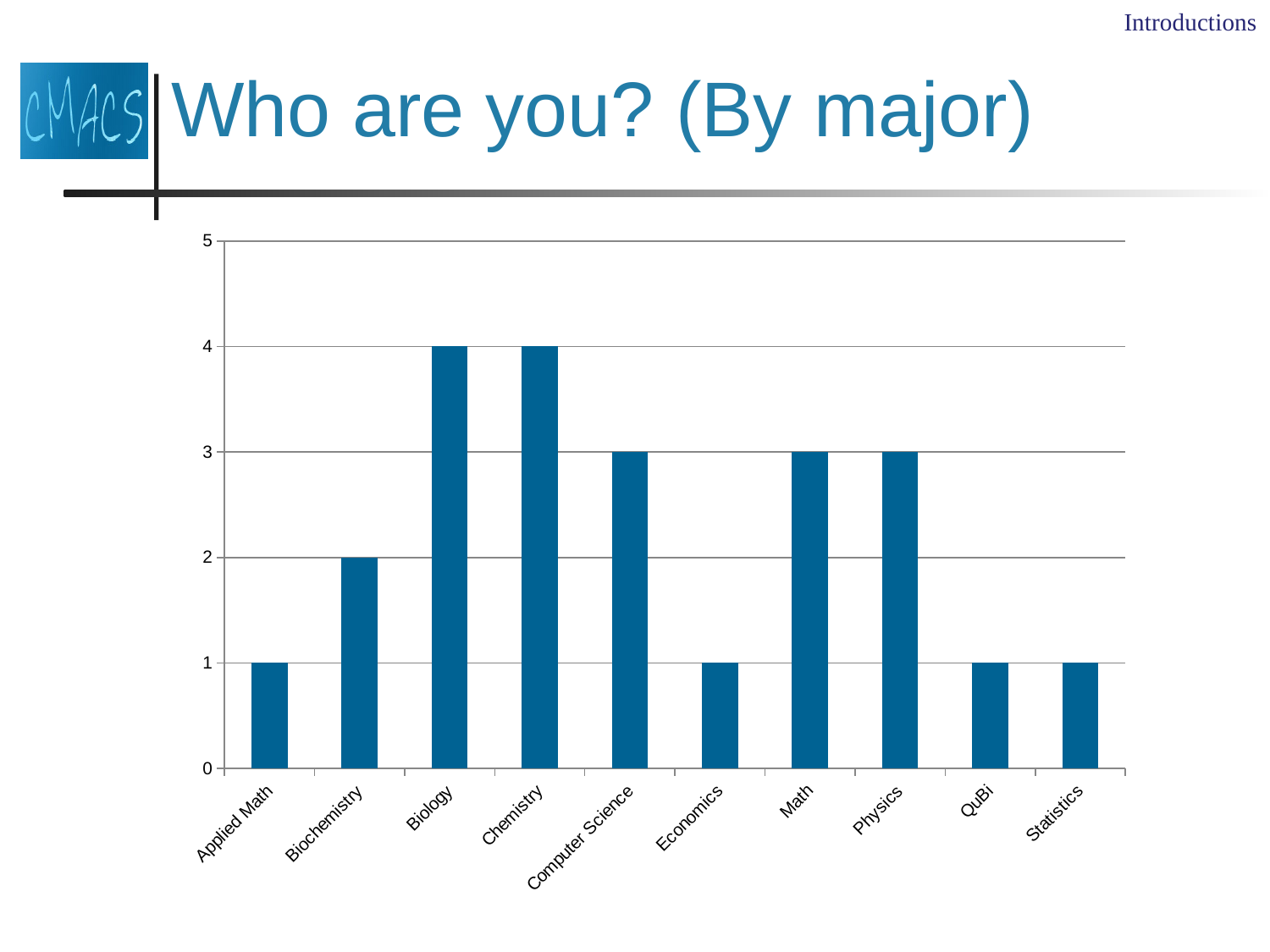
What is the difference between the values for Math and Economics? 2 Which two majors share the highest value? Biology and Chemistry How many majors (categories) are shown on the x axis? 10 What is the value for Biochemistry? 2 What is the value for Biology? 4 Which is larger, the value for Computer Science or the value for Economics? Computer Science What is the value for Computer Science? 3 Is the value for Chemistry greater or less than 3? greater What is the difference between the values for Biology and Biochemistry? 2 What kind of chart is shown on the slide? bar chart What is the title of the slide containing the chart? Who are you? (By major) What is the value for Statistics? 1